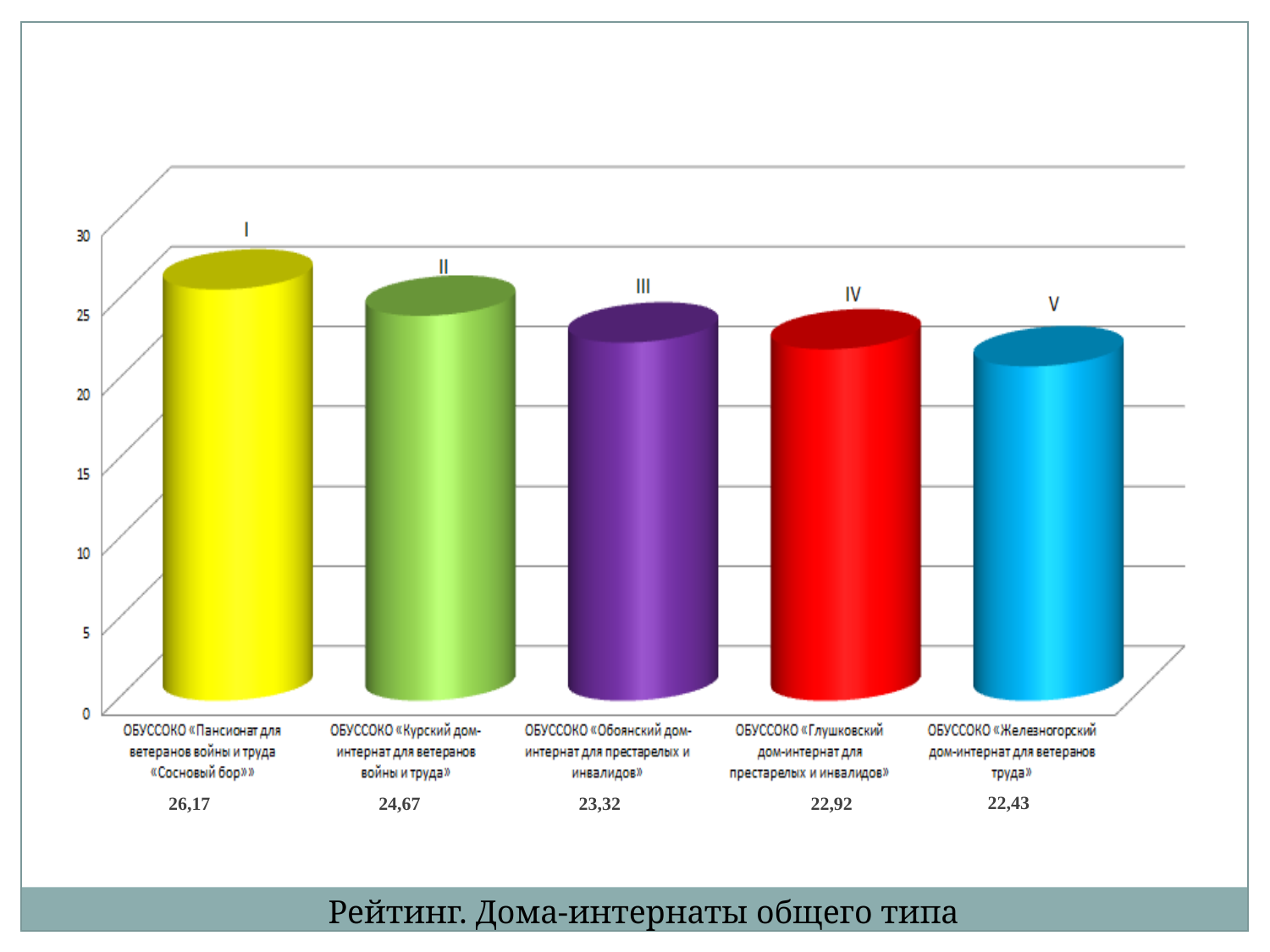
Which category has the lowest value? ОБУССОКО «Железногорский дом-интернат для ветеранов труда» What kind of chart is shown on the slide? bar chart What is the difference between the values for ОБУССОКО «Пансионат для ветеранов войны и труда «Сосновый бор»» and ОБУССОКО «Курский дом-интернат для ветеранов войны и труда»? 1,50 What value is shown for ОБУССОКО «Курский дом-интернат для ветеранов войны и труда»? 24,67 Is the value for ОБУССОКО «Обоянский дом-интернат для престарелых и инвалидов» greater or less than 20? greater What is the difference between the values for ОБУССОКО «Глушковский дом-интернат для престарелых и инвалидов» and ОБУССОКО «Железногорский дом-интернат для ветеранов труда»? 0,49 Which has a larger value: ОБУССОКО «Обоянский дом-интернат для престарелых и инвалидов» or ОБУССОКО «Глушковский дом-интернат для престарелых и инвалидов»? ОБУССОКО «Обоянский дом-интернат для престарелых и инвалидов» What value is shown for ОБУССОКО «Железногорский дом-интернат для ветеранов труда»? 22,43 How many categories are shown in the chart? 5 Do the values rise or fall from left to right along the x axis? fall What value is shown for ОБУССОКО «Пансионат для ветеранов войны и труда «Сосновый бор»»? 26,17 Which category has the highest value? ОБУССОКО «Пансионат для ветеранов войны и труда «Сосновый бор»»